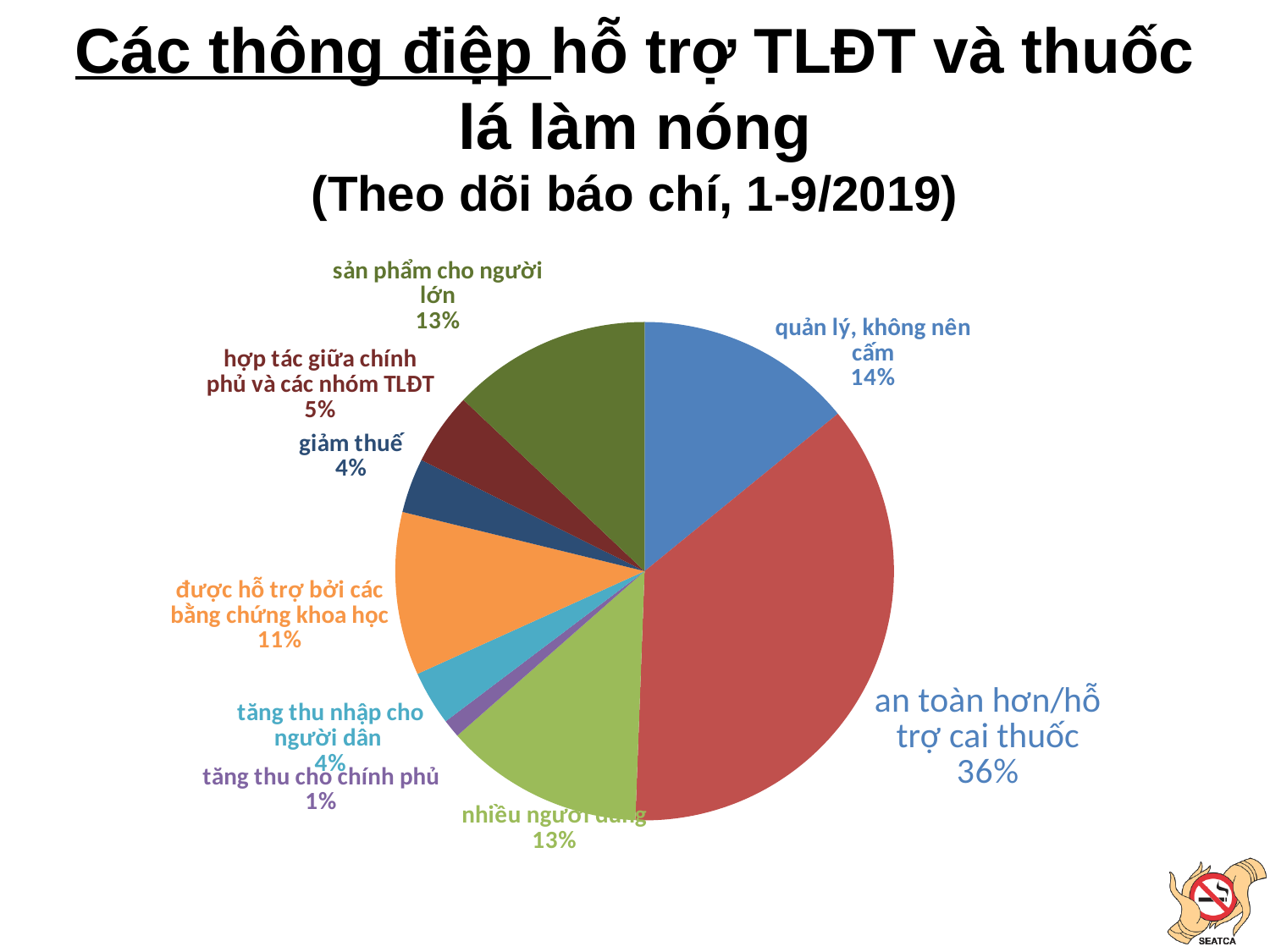
What period does the chart subtitle say the press monitoring covers? 1-9/2019 Which slice of the pie is the smallest? tăng thu cho chính phủ Which slice of the pie is the largest? an toàn hơn/hỗ trợ cai thuốc Which is larger, the share for "sản phẩm cho người lớn" or the share for "được hỗ trợ bởi các bằng chứng khoa học"? sản phẩm cho người lớn How many slices does the pie chart have? 9 What percentage is shown for "được hỗ trợ bởi các bằng chứng khoa học"? 11% What percentage is shown for "giảm thuế"? 4% What kind of chart is shown on the slide? pie chart What percentage is shown for "quản lý, không nên cấm"? 14% What is the difference in percentage points between "an toàn hơn/hỗ trợ cai thuốc" and "quản lý, không nên cấm"? 22 What percentage is shown for "hợp tác giữa chính phủ và các nhóm TLĐT"? 5% What share of the pie is labelled "an toàn hơn/hỗ trợ cai thuốc"? 36%